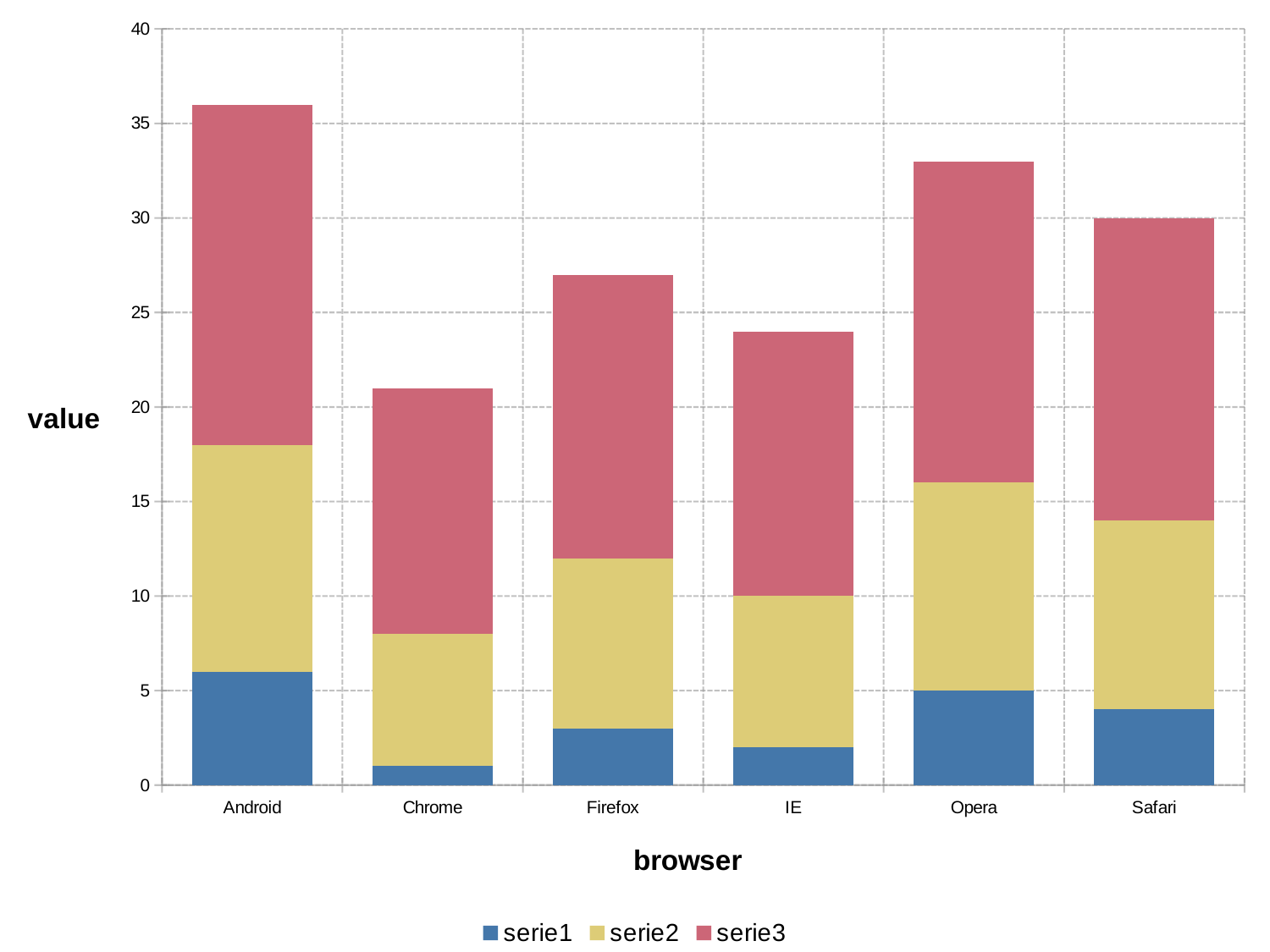
Is the total height of the IE bar greater or less than 25? less What is the total height of the Safari stacked bar? 30 Which browser has the shortest stacked bar overall? Chrome Is the total height of the Android bar greater or less than 35? greater What is the title of the x axis? browser What is the serie1 value for Opera? 5 Is the total height of the Chrome bar greater or less than 25? less Which stacked bar is taller overall, Opera or Firefox? Opera How many series does the legend list? 3 How many browser categories are shown on the x axis? 6 Which browser has the tallest stacked bar overall? Android What kind of chart is shown on the slide? bar chart